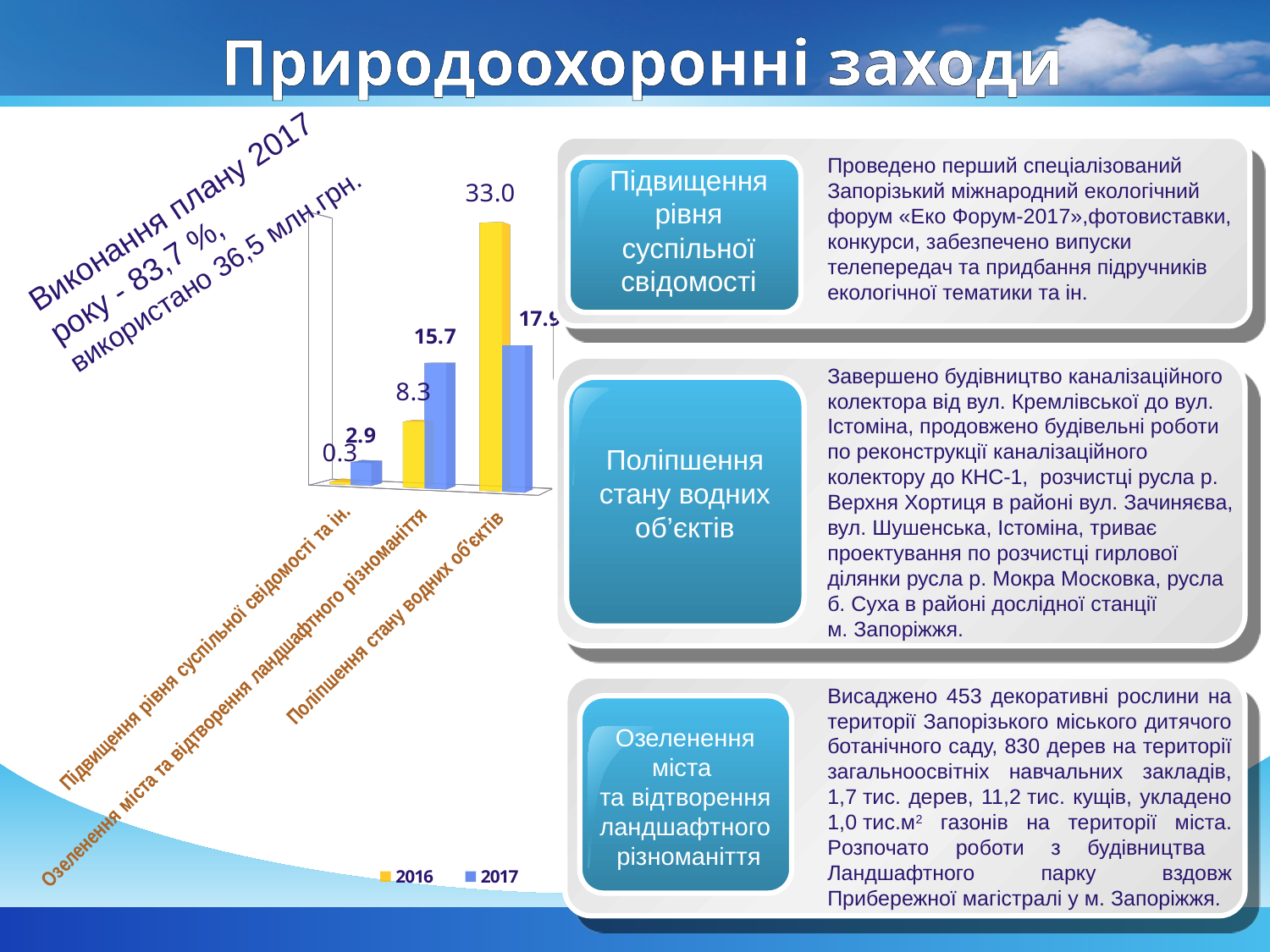
For «Поліпшення стану водних об'єктів», which series has the larger value, 2016 or 2017? 2016 How many series does the chart legend list? 2 Which category has the lowest 2016 value? Підвищення рівня суспільної свідомості та ін. Which category has the highest 2016 value? Поліпшення стану водних об'єктів By how much does the 2017 value exceed the 2016 value for «Озеленення міста та відтворення ландшафтного різноманіття»? 7.4 What is the 2016 value for «Озеленення міста та відтворення ландшафтного різноманіття»? 8.3 What is the 2017 value for «Підвищення рівня суспільної свідомості та ін.»? 2.9 What type of chart is shown on the slide? Bar chart What is the 2017 value for «Озеленення міста та відтворення ландшафтного різноманіття»? 15.7 What is the 2016 value for «Підвищення рівня суспільної свідомості та ін.»? 0.3 How many categories are shown on the x axis of the chart? 3 What is the 2016 value for «Поліпшення стану водних об'єктів»? 33.0